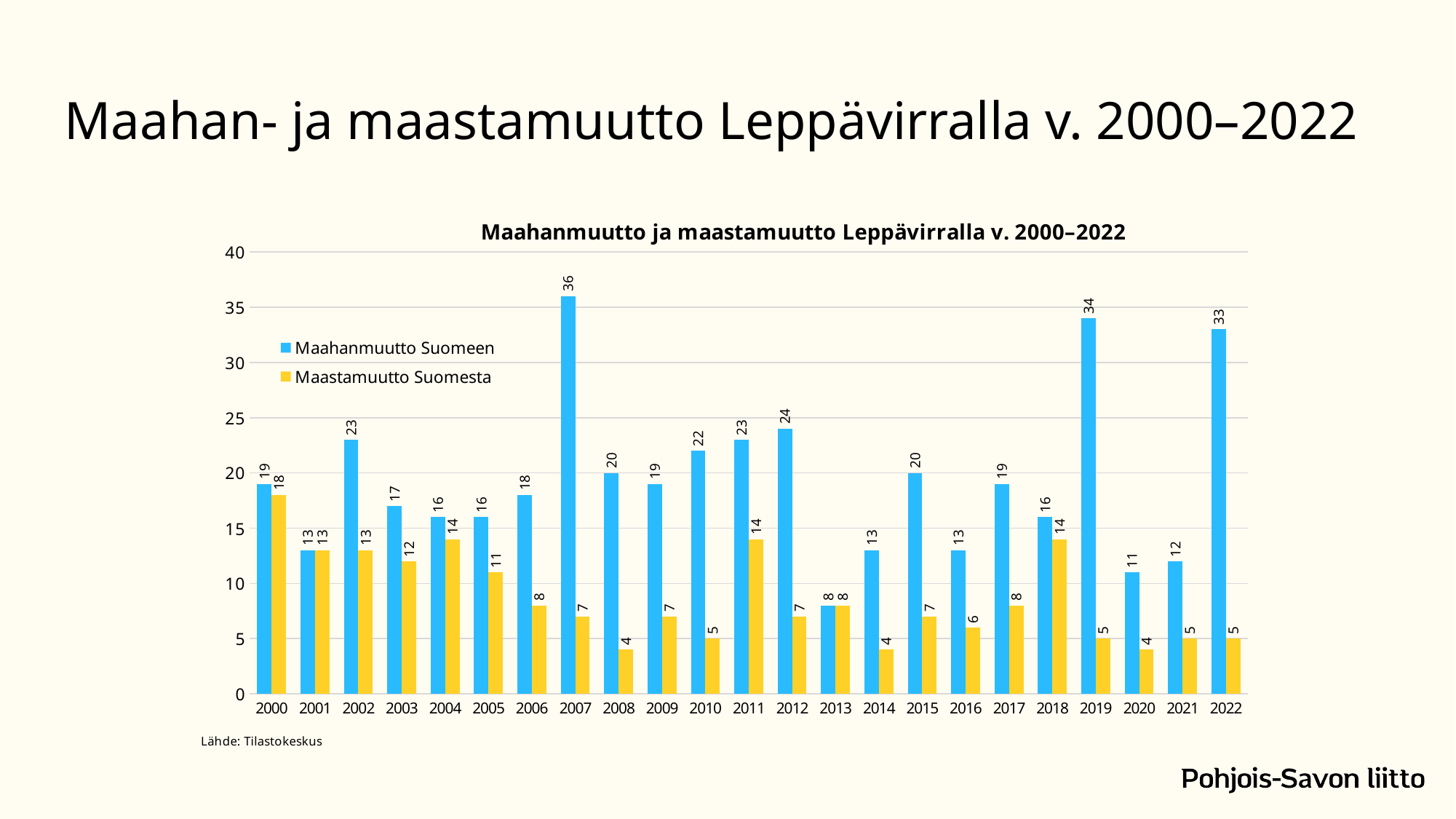
What is the total of Maahanmuutto Suomeen and Maastamuutto Suomesta in 2000? 37 Which is larger in 2004: Maahanmuutto Suomeen or Maastamuutto Suomesta? Maahanmuutto Suomeen What colour are the bars for Maastamuutto Suomesta? Yellow What kind of chart is shown on the slide? Bar chart What is the value of Maastamuutto Suomesta in 2011? 14 What is the difference between Maahanmuutto Suomeen and Maastamuutto Suomesta in 2022? 28 Which year has the highest value for Maastamuutto Suomesta? 2000 How many series does the legend list? 2 How many years are shown on the x axis? 23 Which year has the lowest value for Maahanmuutto Suomeen? 2013 Which year has the highest value for Maahanmuutto Suomeen? 2007 What is the value of Maahanmuutto Suomeen in 2007? 36